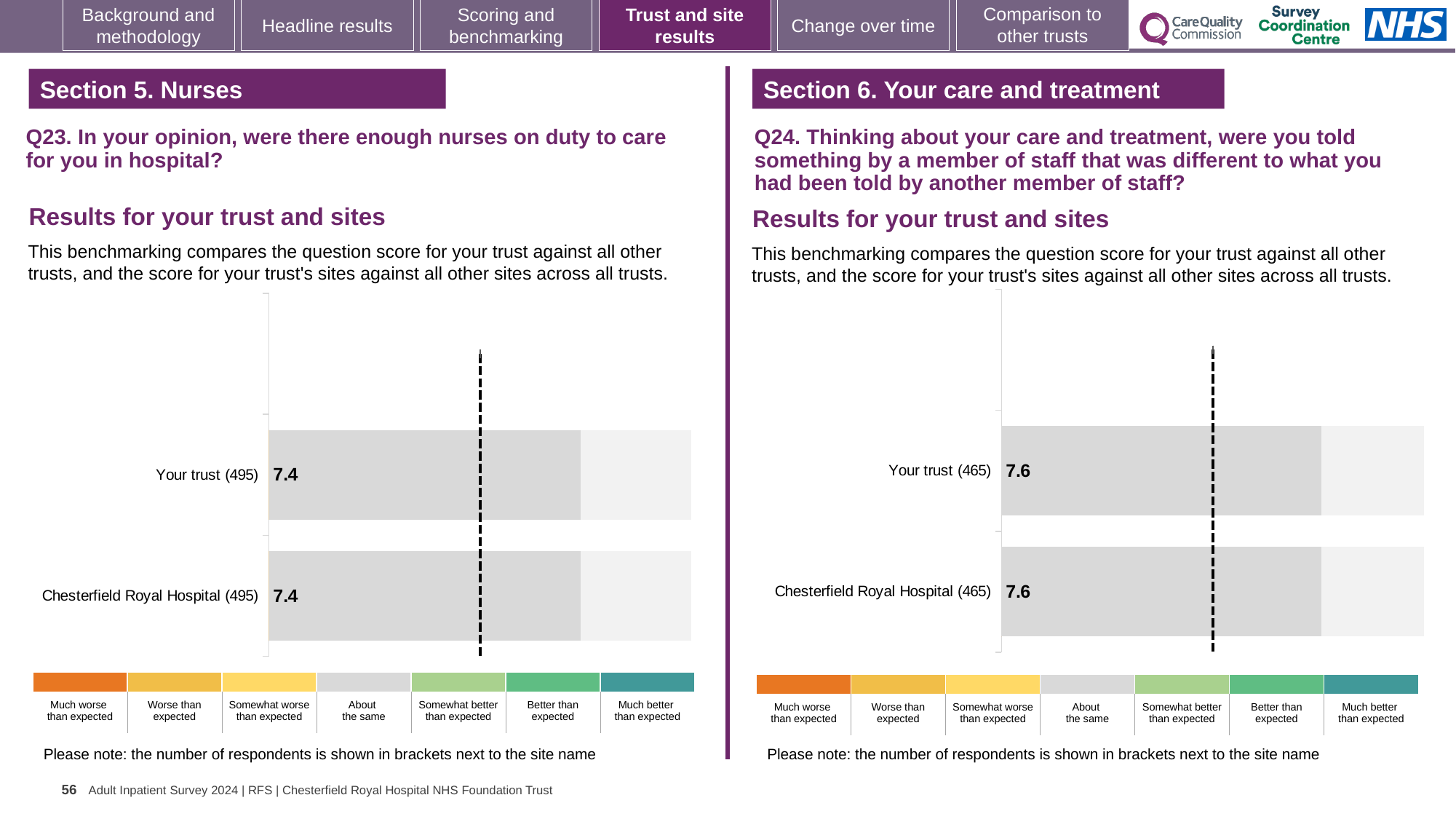
In the Q24 chart on the right, what is the score for Your trust? 7.6 In the Q23 chart on the left, what is the score for Your trust? 7.4 In the Q23 chart on the left, what is the score for Chesterfield Royal Hospital? 7.4 How many bars are plotted in the Q24 chart on the right? 2 Is the score for Your trust in the Q24 chart on the right larger than the score for Your trust in the Q23 chart on the left? Yes In the Q24 chart on the right, what is the difference between the score for Your trust and the score for Chesterfield Royal Hospital? 0 In the Q24 chart on the right, what is the score for Chesterfield Royal Hospital? 7.6 In the Q24 chart on the right, how many respondents are shown in brackets next to Chesterfield Royal Hospital? 465 In the Q23 chart on the left, how many respondents are shown in brackets next to Your trust? 495 How many bars are plotted in the Q23 chart on the left? 2 In the Q23 chart on the left, what is the difference between the score for Your trust and the score for Chesterfield Royal Hospital? 0 What kind of chart is the Q23 chart on the left? Bar chart